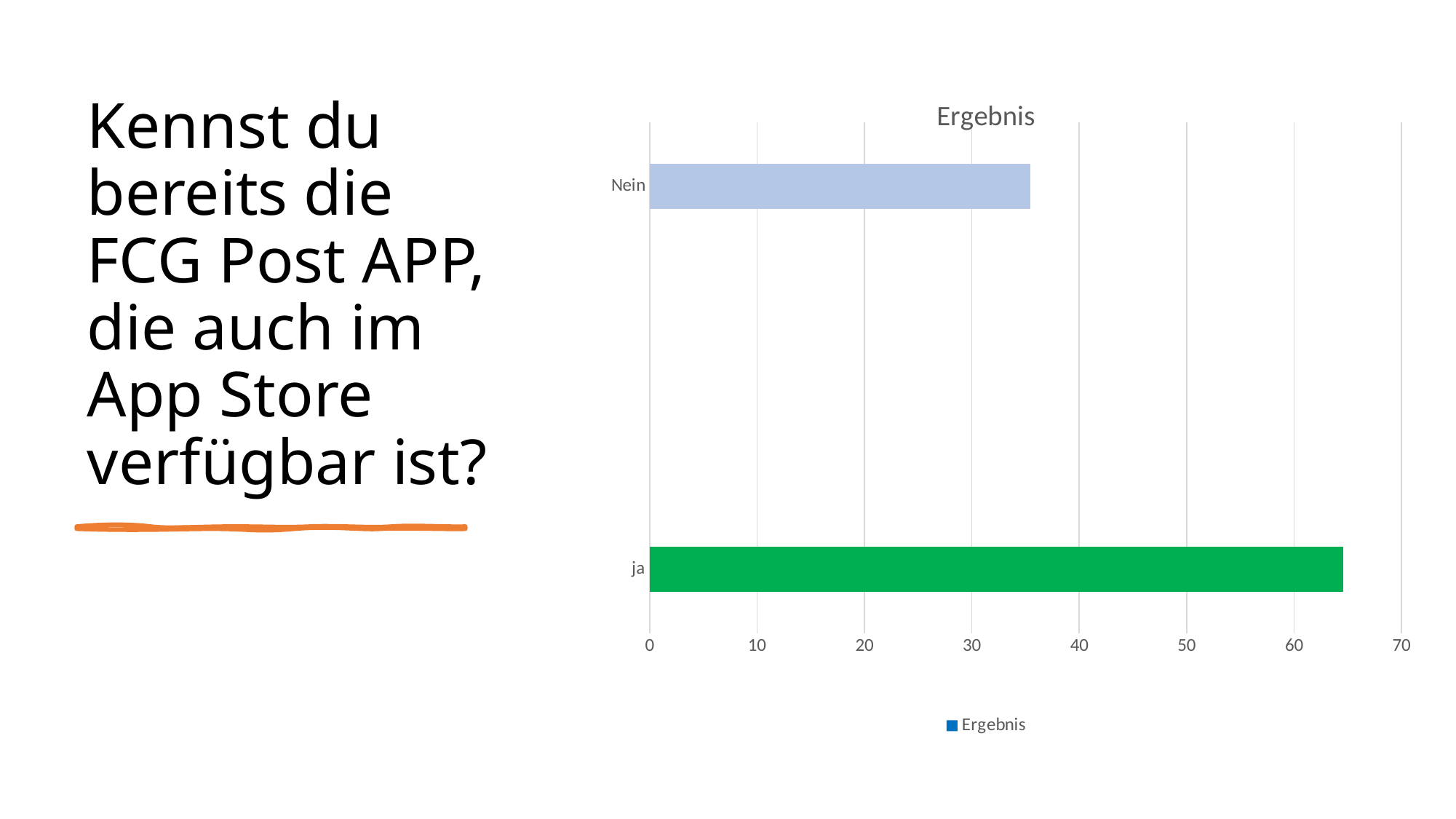
Which category has the lowest value? Nein Is the value for Nein greater or less than 30? greater Which category has the highest value? ja What is the highest value shown on the x axis? 70 How many series does the legend list? 1 Is the value for Nein greater or less than 40? less What kind of chart is shown on the slide? bar chart Is the value for ja greater or less than 60? greater How many categories does the chart show? 2 What is the title of the chart? Ergebnis Which is larger, the value for ja or the value for Nein? ja